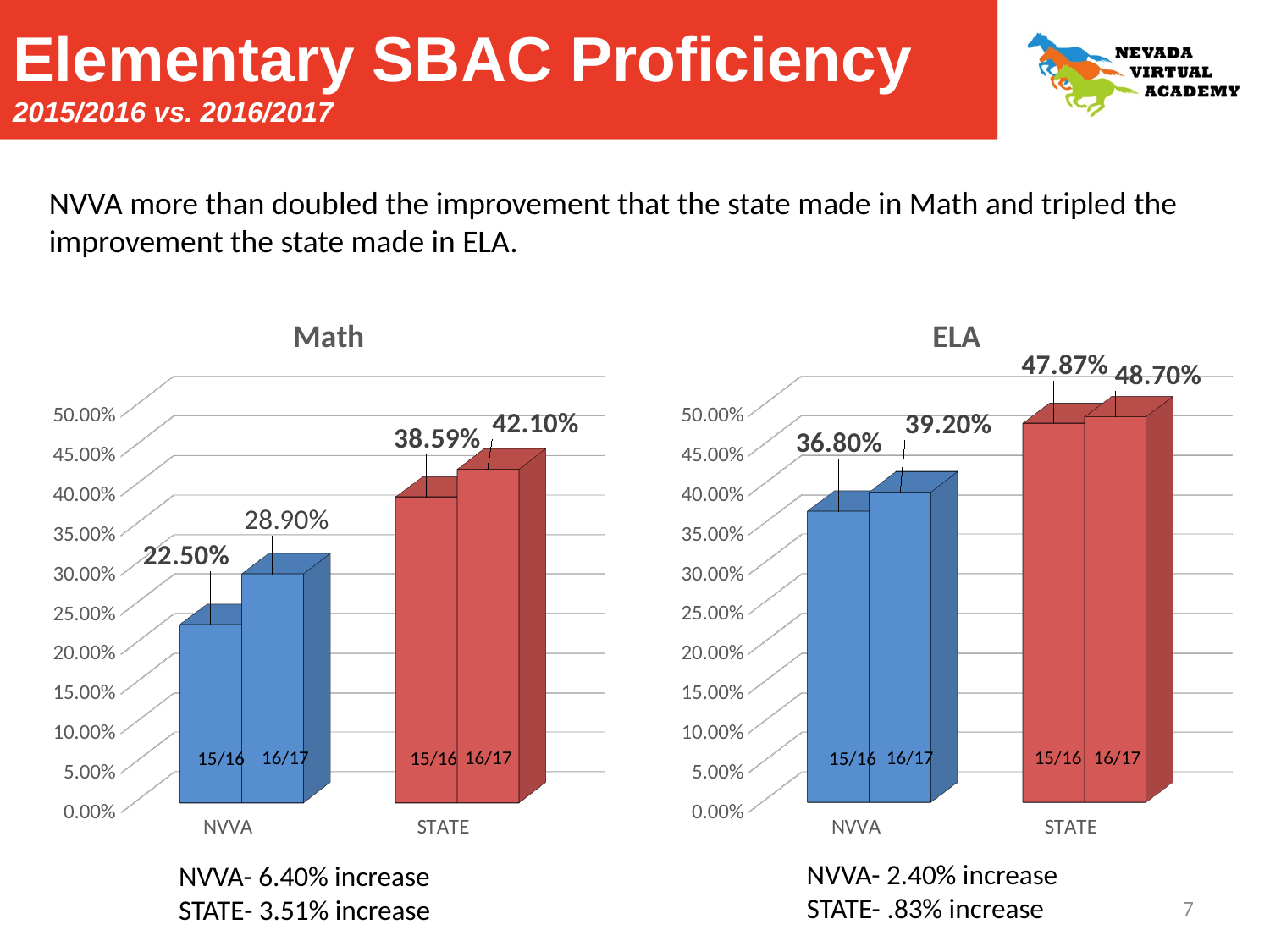
In the Math chart, what is the 15/16 value for STATE? 38.59% In the ELA chart, what is the difference between the STATE 16/17 and 15/16 values? 0.83% In the Math chart, what is the 16/17 value for NVVA? 28.90% In the Math chart, which bar is the highest? STATE 16/17 In the Math chart, which bar is the lowest? NVVA 15/16 In the ELA chart, what is the 15/16 value for NVVA? 36.80% What kind of chart is the ELA chart? bar chart In the Math chart, is the NVVA 15/16 value greater or less than 25.00%? less In the Math chart, what is the difference between the NVVA 16/17 and 15/16 values? 6.40% How many categories are shown on the x axis of the Math chart? 2 In the ELA chart, which is larger: the NVVA 16/17 value or the STATE 15/16 value? STATE 15/16 In the ELA chart, what is the 16/17 value for STATE? 48.70%